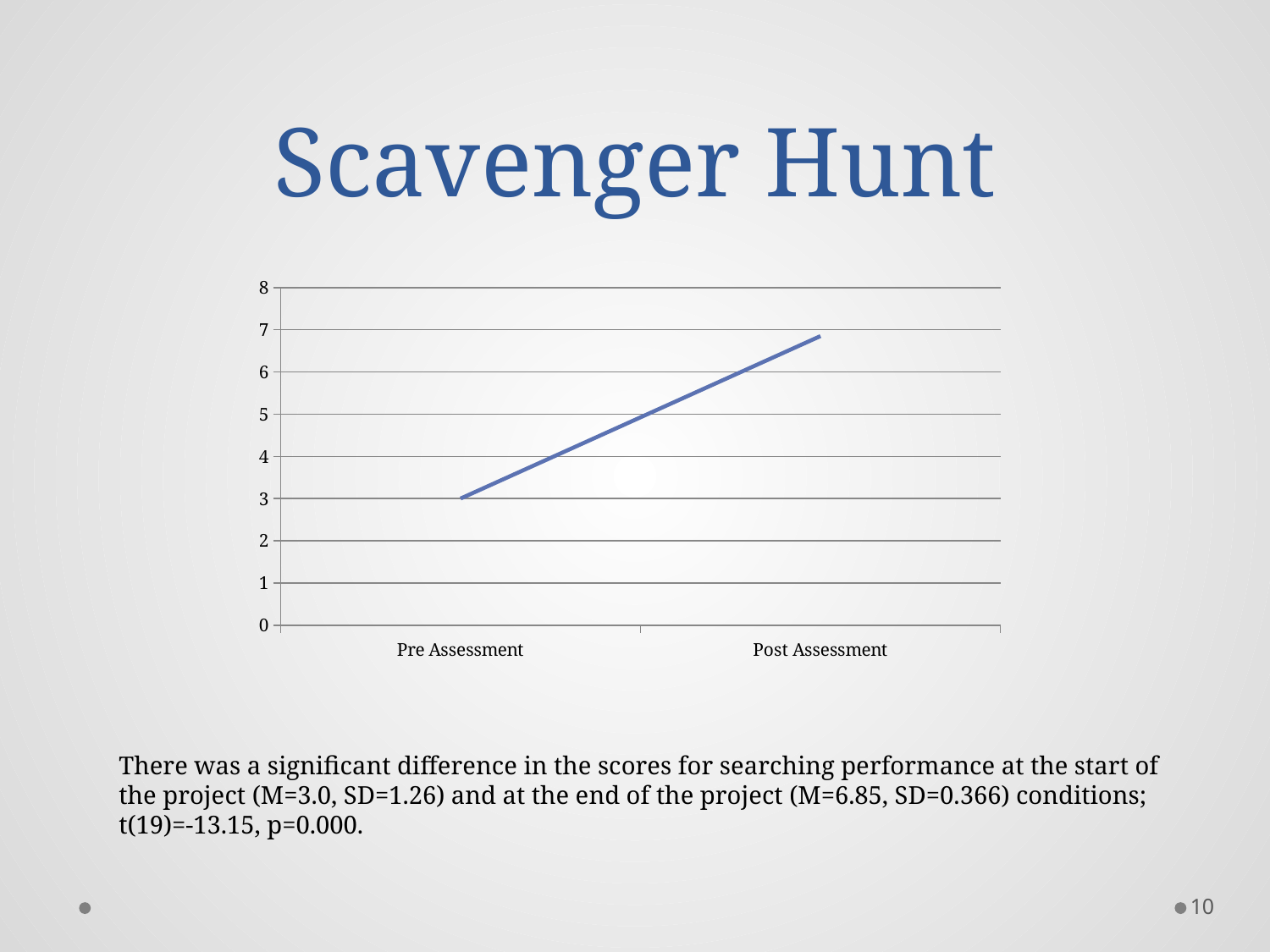
What kind of chart is shown on the slide? line chart Is the value for Pre Assessment greater or less than 4? less How many categories are plotted on the x axis? 2 Is the value for Post Assessment greater or less than 7? less Is the value for Post Assessment greater or less than 6? greater What is the title of the slide containing the chart? Scavenger Hunt Which category has the highest value? Post Assessment What is the highest tick value shown on the y axis? 8 Do the values rise or fall from Pre Assessment to Post Assessment? rise Which is larger, the value for Pre Assessment or Post Assessment? Post Assessment Which category has the lowest value? Pre Assessment What is the value for Pre Assessment? 3